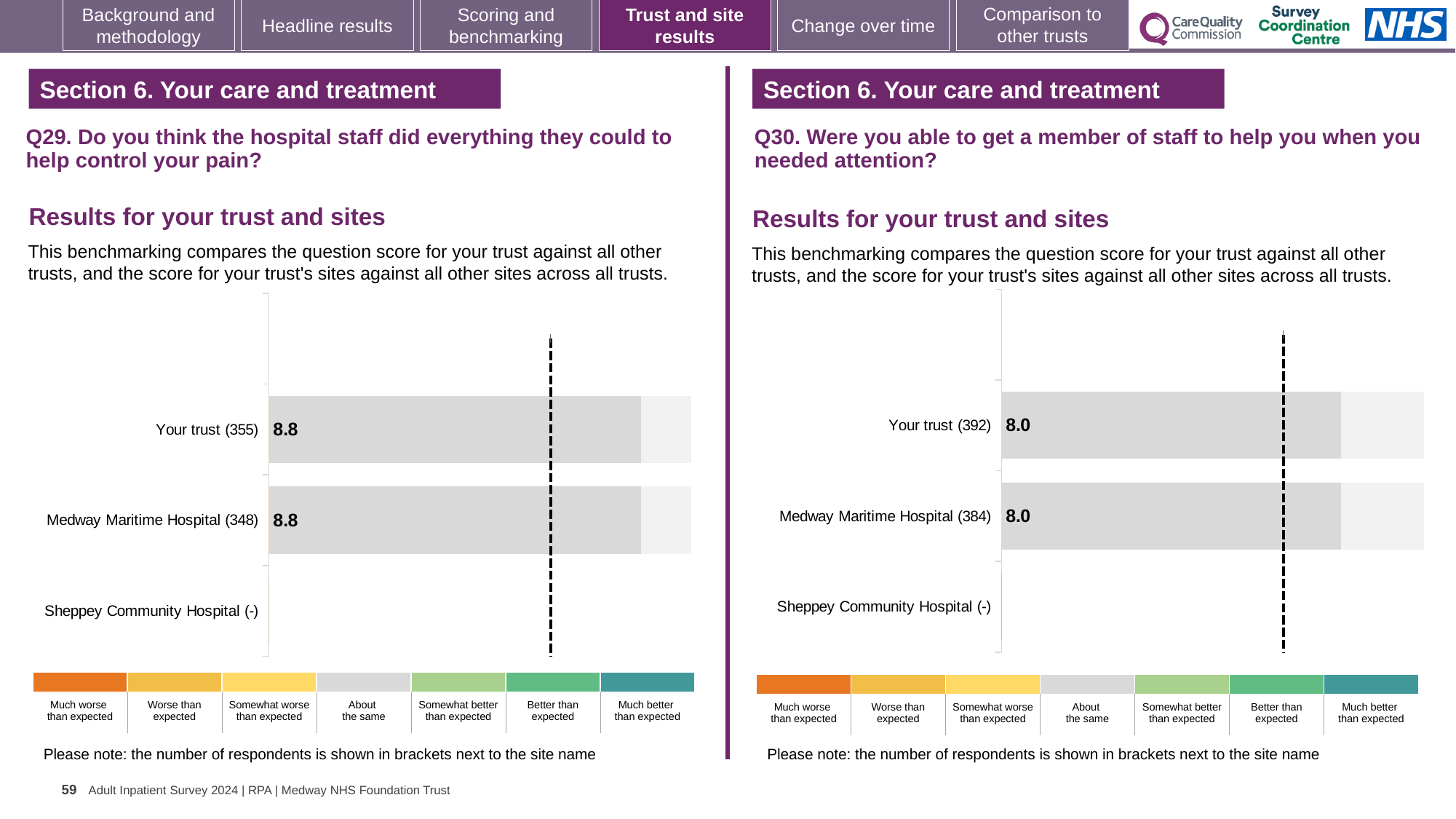
On the Q30 chart (right), what is the score for Medway Maritime Hospital? 8.0 What kind of chart is the Q29 chart (left)? Bar chart On the Q29 chart (left), what is the score for Medway Maritime Hospital? 8.8 On the Q29 chart (left), what is the score for Your trust? 8.8 On the Q30 chart (right), how many respondents are shown in brackets for Medway Maritime Hospital? 384 On the Q29 chart (left), what is the difference between the scores for Your trust and Medway Maritime Hospital? 0.0 Is the score for Your trust on the Q29 chart (left) larger or smaller than the score for Your trust on the Q30 chart (right)? Larger How many categories are listed on the Q29 chart (left)? 3 On the Q29 chart (left), how many respondents are shown in brackets for Your trust? 355 On the Q30 chart (right), what is the score for Your trust? 8.0 How many categories are listed on the Q30 chart (right)? 3 On the Q30 chart (right), what is the difference between the scores for Your trust and Medway Maritime Hospital? 0.0